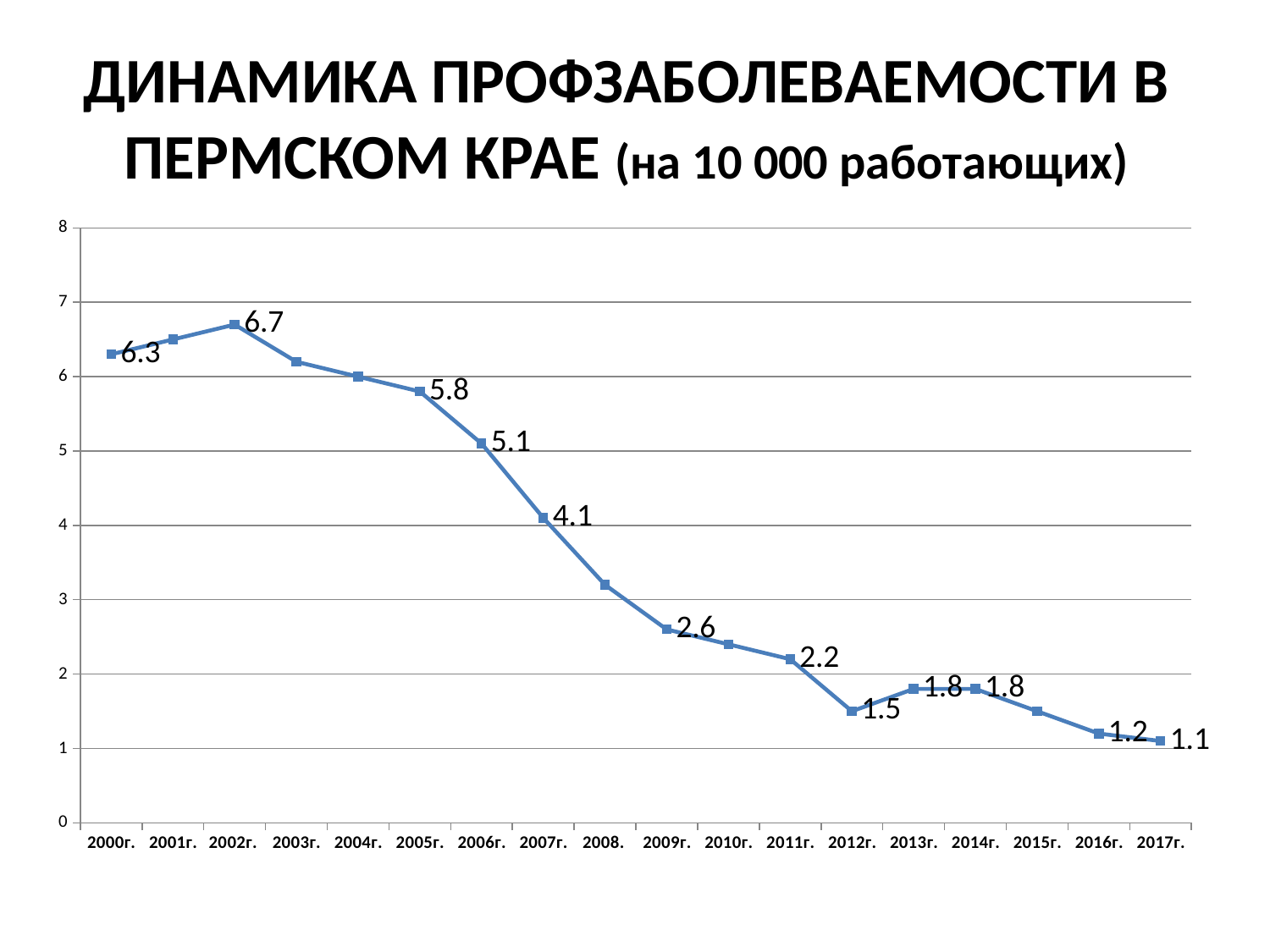
What is the value for 2002г.? 6.7 What is the difference between the values for 2005г. and 2006г.? 0.7 Which is larger, the value for 2009г. or the value for 2011г.? 2009г. Which year has the lowest value? 2017г. Which year has the highest value? 2002г. What is the value for 2012г.? 1.5 How many years are plotted on the x axis? 18 What is the value for 2007г.? 4.1 What kind of chart is shown on the slide? line chart Is the value for 2008. greater or less than 4? less Do the values generally rise or fall from 2002г. to 2017г.? fall What is the difference between the values for 2002г. and 2017г.? 5.6